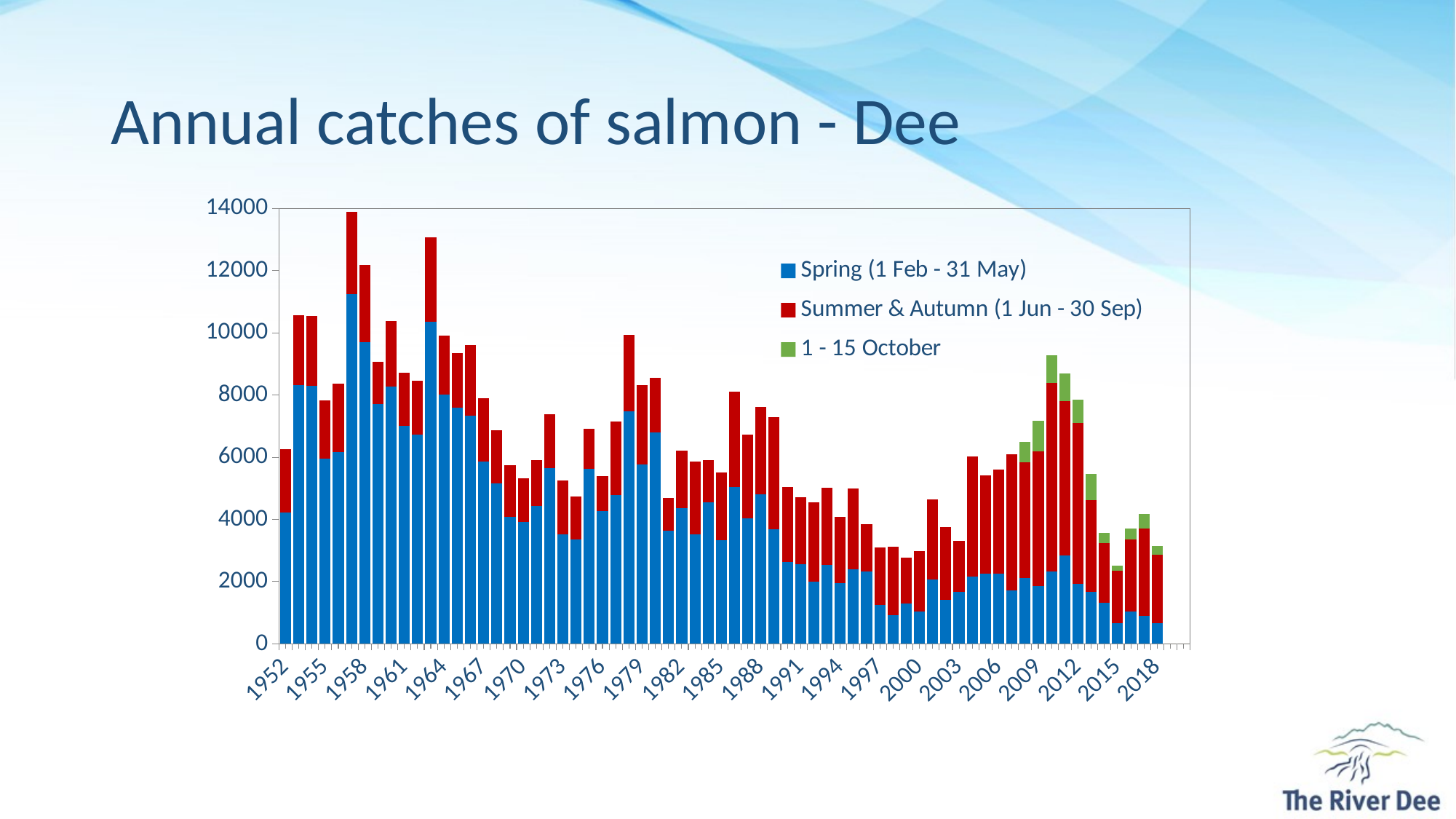
Is the total catch for 1999 greater or less than 4000? less Which year has the highest total annual catch in the chart? 1957 Is the total catch for 2011 greater or less than 8000? greater What is the title of the chart? Annual catches of salmon - Dee What kind of chart is shown on the slide? Stacked bar chart Which colour represents the '1 - 15 October' series in the chart? Green Which year has the larger total catch, 1979 or 1982? 1979 How many series does the legend list? 3 Overall, do total annual catches rise or fall from 1952 to 2018? Fall Is the total catch for 1952 greater or less than 8000? less Which year has the larger total catch, 1952 or 1958? 1958